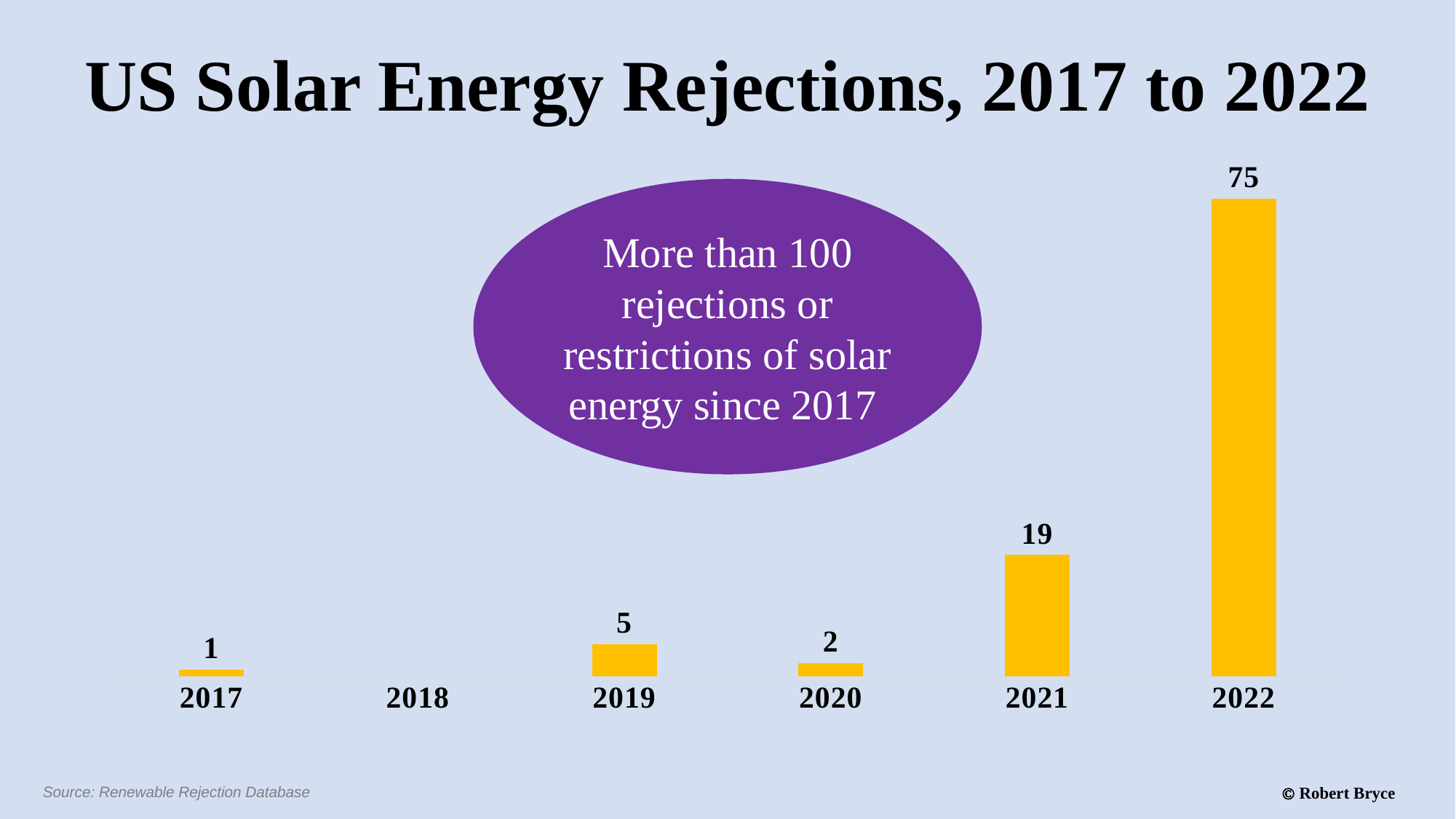
What is the value for 2021? 19 Which year has the highest value? 2022 How many years are shown on the x axis? 6 What is the difference between the values for 2022 and 2021? 56 What is the title of the chart? US Solar Energy Rejections, 2017 to 2022 What kind of chart is this? bar chart What is the value for 2019? 5 Which is larger, the value for 2019 or the value for 2020? 2019 Do the values generally rise or fall from 2019 to 2022? rise What is the value for 2022? 75 What is the value for 2017? 1 Which year has the lowest value among the years with a visible bar? 2017